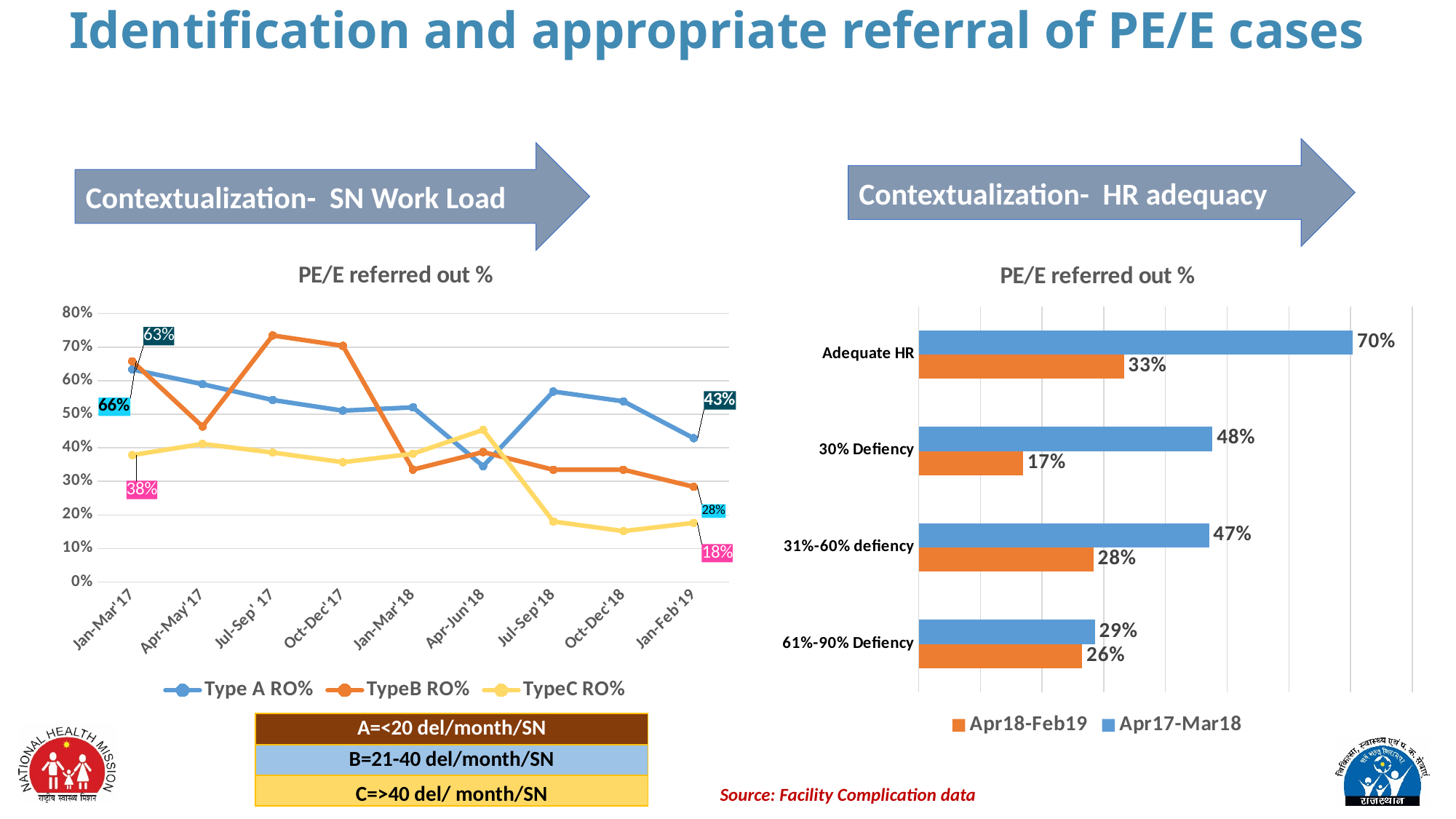
What kind of chart is the chart on the right side of the slide? bar chart How many series does the legend of the chart on the right list? 2 In the chart on the right, what is the value for Adequate HR in the Apr17-Mar18 series? 70% In the chart on the right, which category has the highest Apr17-Mar18 value? Adequate HR How many categories are shown in the chart on the right? 4 In the chart on the right, what is the value for 30% Defiency in the Apr18-Feb19 series? 17% In the line chart on the left, what is the value for Type A RO% at Jan-Feb'19? 43% How many time periods are shown on the x axis of the line chart on the left? 9 In the chart on the right, for 61%-90% Defiency, which series has the larger value? Apr17-Mar18 How many series does the legend of the line chart on the left list? 3 In the chart on the right, what is the difference between the Apr17-Mar18 and Apr18-Feb19 values for Adequate HR? 37 percentage points In the chart on the right, which category has the lowest Apr18-Feb19 value? 30% Defiency